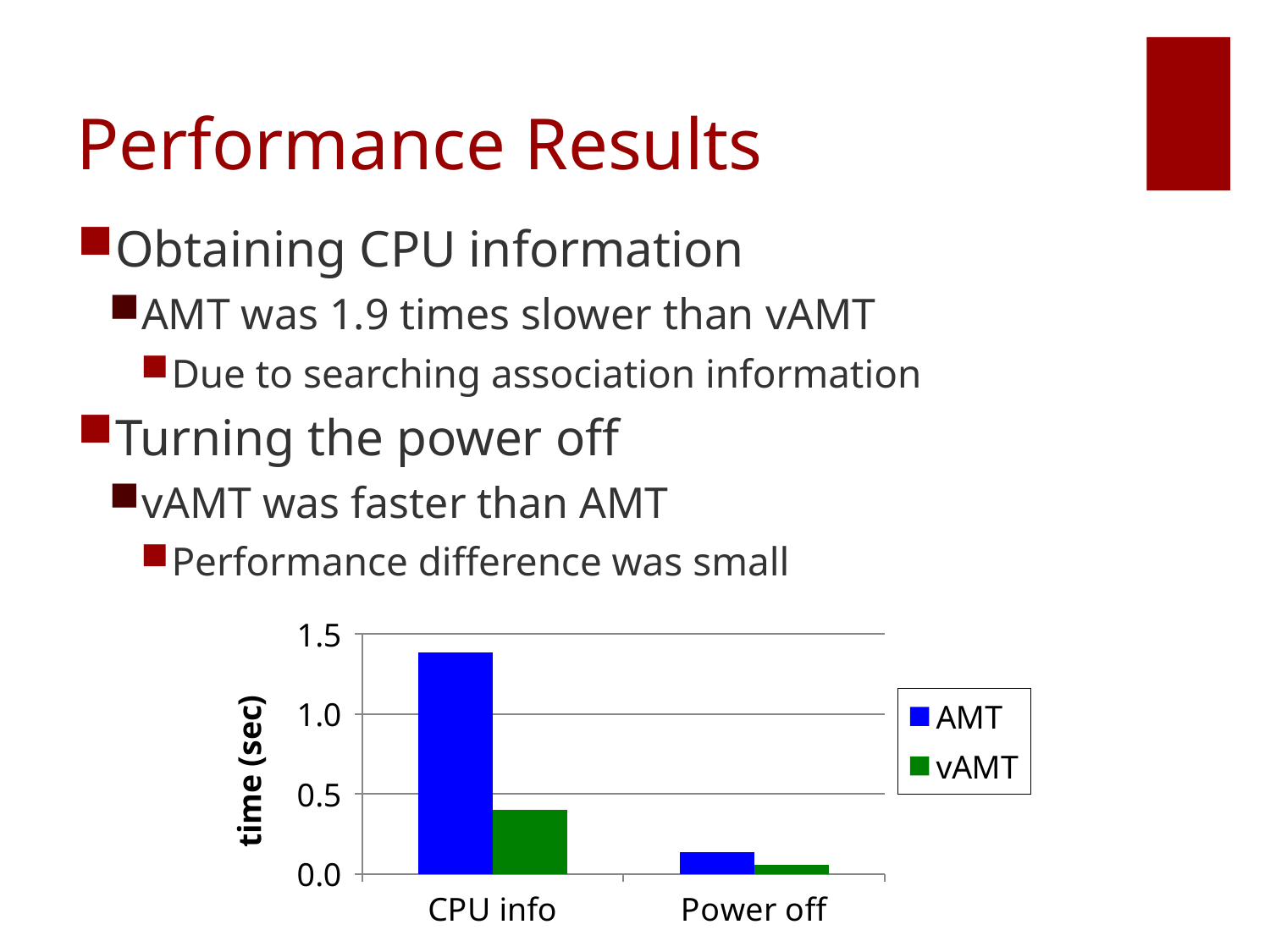
Is the vAMT value for CPU info greater or less than 0.5? less Is the AMT value for Power off greater or less than 0.5? less Which bar in the chart is the shortest? vAMT for Power off How many categories are shown on the x axis of the chart? 2 How many series does the chart's legend list? 2 What is the label of the chart's vertical axis? time (sec) Is the AMT value for CPU info greater or less than 1.0? greater For Power off, which series has the larger value, AMT or vAMT? AMT Which bar in the chart is the tallest? AMT for CPU info What kind of chart is shown on the slide? bar chart For CPU info, which series has the larger value, AMT or vAMT? AMT What are the two series listed in the chart's legend? AMT and vAMT